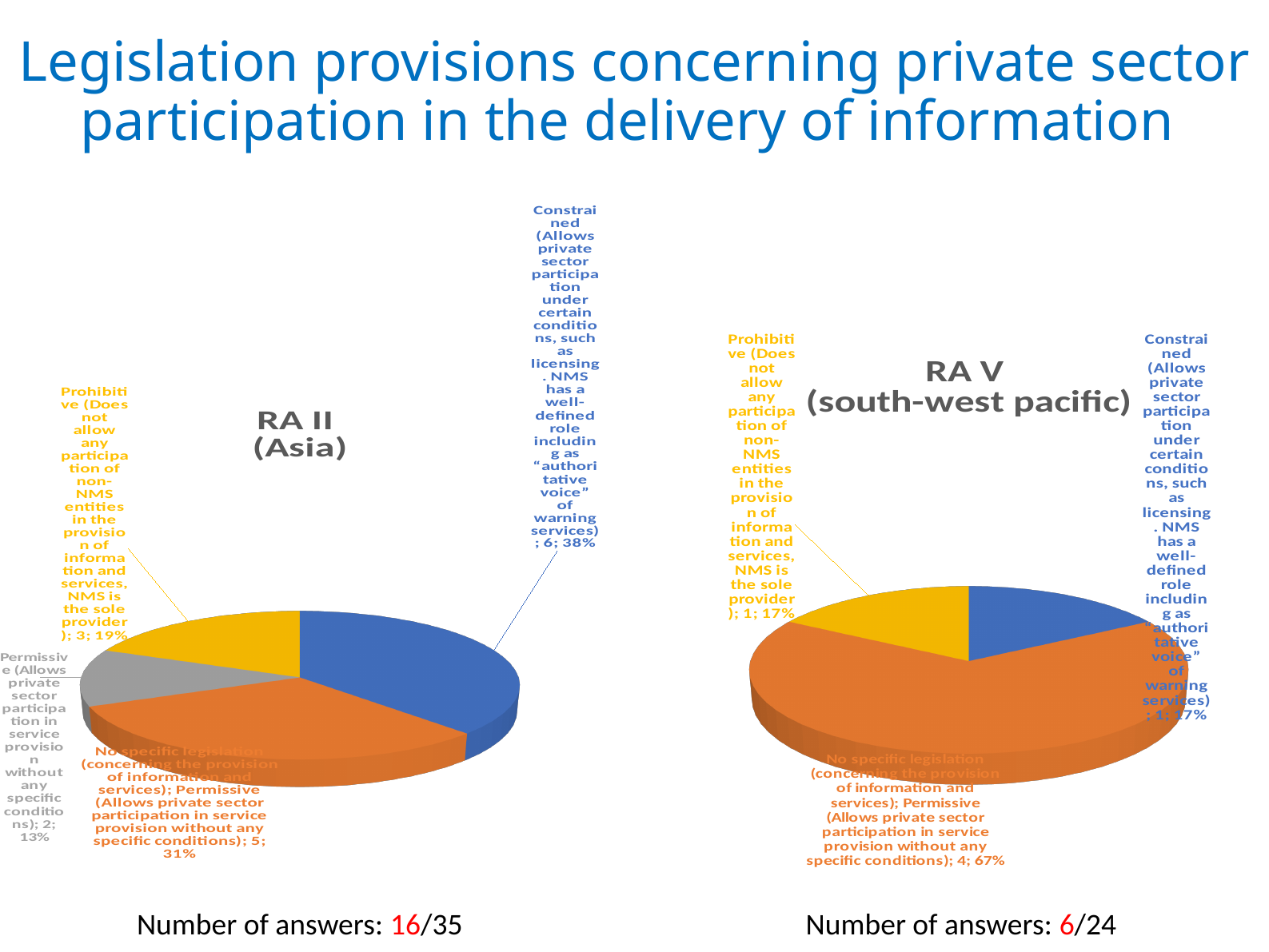
In the RA V (south-west pacific) chart, how many categories are shown? 3 In the RA V (south-west pacific) chart, which category has the largest value? No specific legislation In the RA V (south-west pacific) chart, what percentage share does the Constrained category have? 17% In the RA II (Asia) chart, which category has the largest value? Constrained In the RA II (Asia) chart, how many categories are shown? 4 In the RA II (Asia) chart, what percentage share does the Prohibitive category have? 19% In the RA II (Asia) chart, what is the difference between the Constrained value and the Permissive value? 4 In the RA II (Asia) chart, is the value for No specific legislation larger or smaller than the value for Prohibitive? Larger In the RA II (Asia) chart, what is the value for the Constrained category? 6 What kind of chart is the RA V (south-west pacific) chart? Pie chart In the RA II (Asia) chart, which category has the smallest value? Permissive In the RA V (south-west pacific) chart, what is the value for the No specific legislation category? 4